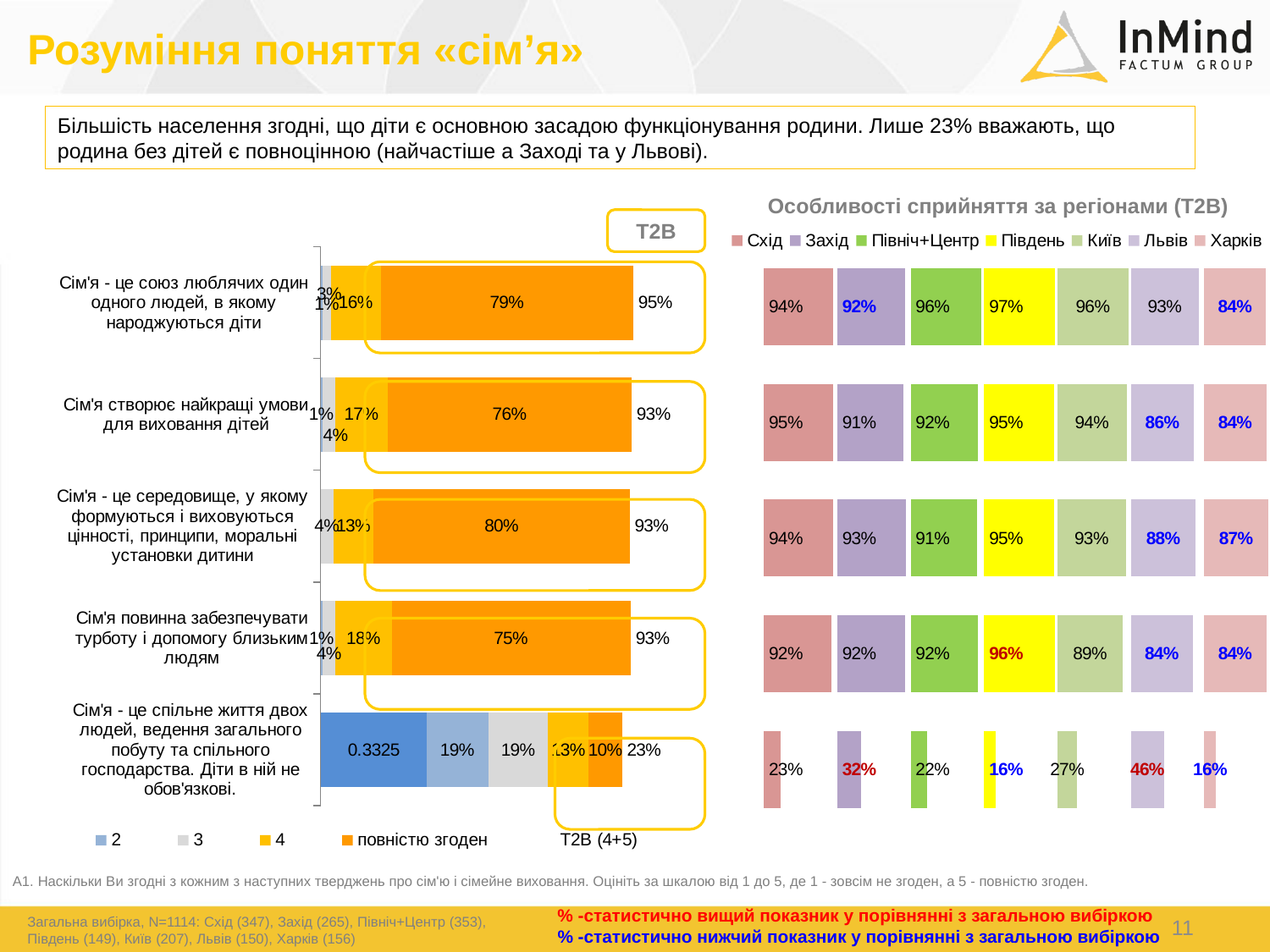
On the left stacked bar chart, what share answered "повністю згоден" for the statement "Сім'я - це середовище, у якому формуються і виховуються цінності, принципи, моральні установки дитини"? 80% On the right chart "Особливості сприйняття за регіонами (T2B)", which region has the highest value for the statement "Сім'я - це союз люблячих один одного людей, в якому народжуються діти"? Південь On the right chart "Особливості сприйняття за регіонами (T2B)", which is larger for the statement "Сім'я створює найкращі умови для виховання дітей": Схід or Харків? Схід What type of chart is the left chart? Stacked bar chart On the left stacked bar chart, which statement has the lowest T2B value? Сім'я - це спільне життя двох людей, ведення загального побуту та спільного господарства. Діти в ній не обов'язкові. On the left stacked bar chart, what is the difference between the T2B value for "Сім'я - це союз люблячих один одного людей, в якому народжуються діти" and the T2B value for "Сім'я - це спільне життя двох людей..."? 72% On the right chart "Особливості сприйняття за регіонами (T2B)", what is the value for Львів for the statement "Сім'я - це спільне життя двох людей..."? 46% On the left stacked bar chart, how many statements are shown? 5 On the right chart "Особливості сприйняття за регіонами (T2B)", what is the difference between Львів and Південь for the statement "Сім'я - це спільне життя двох людей..."? 30% On the right chart "Особливості сприйняття за регіонами (T2B)", how many regions does the legend list? 7 What is the title of the right chart? Особливості сприйняття за регіонами (T2B) On the left stacked bar chart, what is the T2B value for the statement "Сім'я - це союз люблячих один одного людей, в якому народжуються діти"? 95%